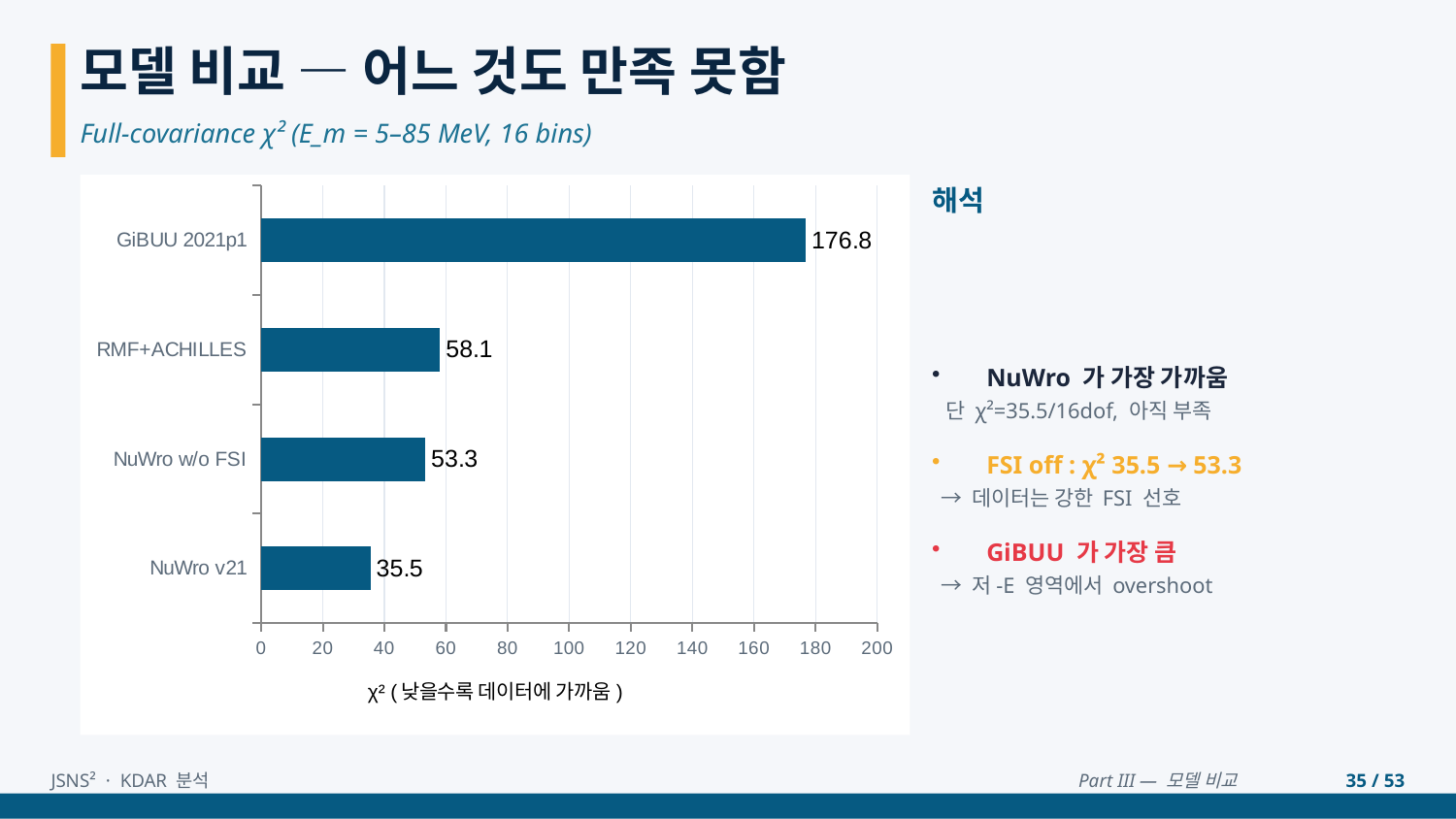
Which model has the highest χ² value? GiBUU 2021p1 What kind of chart is shown on the slide? Bar chart What is the difference between the χ² values of NuWro w/o FSI and NuWro v21? 17.8 What is the χ² value for NuWro v21? 35.5 What is the χ² value for GiBUU 2021p1? 176.8 Which has a larger χ² value, RMF+ACHILLES or NuWro w/o FSI? RMF+ACHILLES How many models are shown in the chart? 4 What is the x-axis label of the chart? χ² ( 낮을수록 데이터에 가까움 ) What is the χ² value for RMF+ACHILLES? 58.1 Which model has the lowest χ² value? NuWro v21 What is the χ² value for NuWro w/o FSI? 53.3 What is the difference between the χ² values of GiBUU 2021p1 and RMF+ACHILLES? 118.7